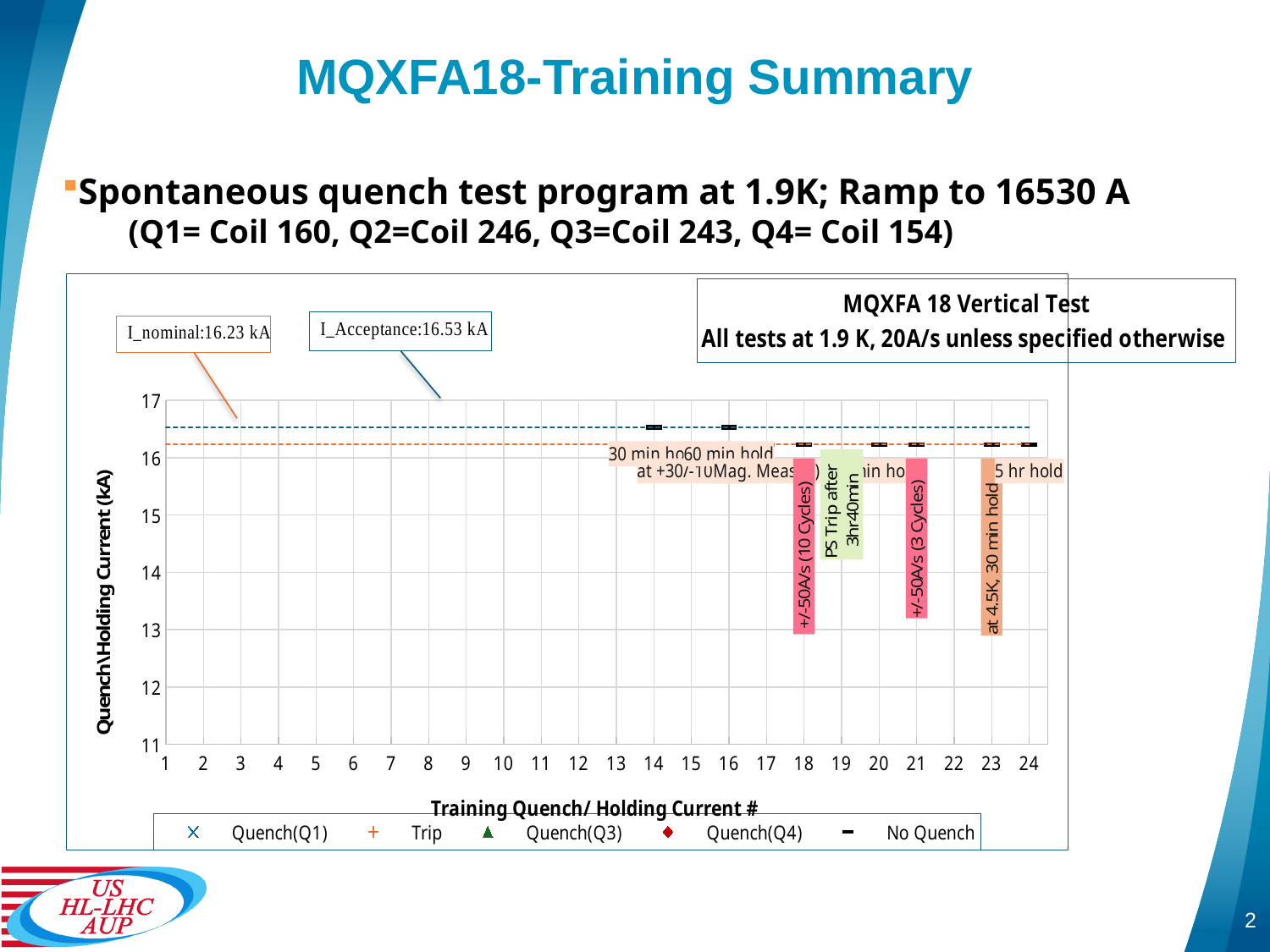
Which plotted point is higher: the one at #14 or the one at #18? #14 What kind of chart is shown on the slide? scatter chart Which legend series do the plotted markers on the chart belong to? No Quench Is the value plotted at training quench/holding current #18 greater or less than 16? greater What is the x-axis title of the chart? Training Quench/ Holding Current # What is the I_nominal value annotated on the chart? 16.23 kA How many tick labels are shown on the x axis of the chart? 24 How many series does the chart legend list? 5 Is the value plotted at training quench/holding current #24 greater or less than 15? greater Is the value plotted at training quench/holding current #14 greater or less than 17? less